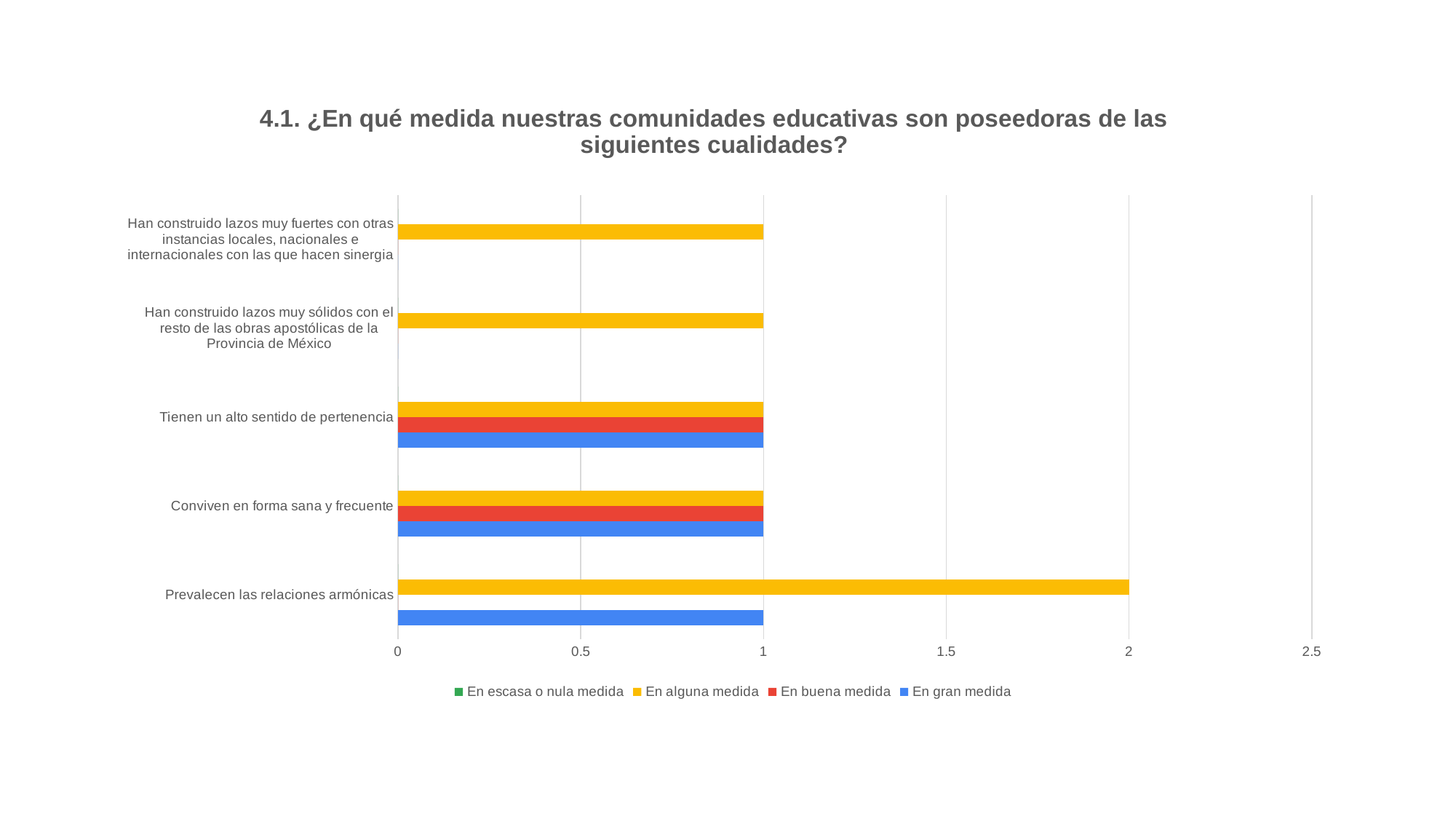
Which category has the highest value for 'En alguna medida'? Prevalecen las relaciones armónicas What is the value of 'En alguna medida' for 'Prevalecen las relaciones armónicas'? 2 How many series does the legend list? 4 What is the value of 'En alguna medida' for 'Han construido lazos muy sólidos con el resto de las obras apostólicas de la Provincia de México'? 1 Is the 'En alguna medida' value for 'Prevalecen las relaciones armónicas' greater or less than 1.5? greater What is the value of 'En buena medida' for 'Tienen un alto sentido de pertenencia'? 1 What kind of chart is shown on the slide? bar chart What is the value of 'En gran medida' for 'Prevalecen las relaciones armónicas'? 1 Which is larger for 'Prevalecen las relaciones armónicas': 'En alguna medida' or 'En gran medida'? En alguna medida Which legend entry is shown in green? En escasa o nula medida How many categories are shown on the vertical axis? 5 What is the difference between the 'En alguna medida' and 'En gran medida' values for 'Prevalecen las relaciones armónicas'? 1